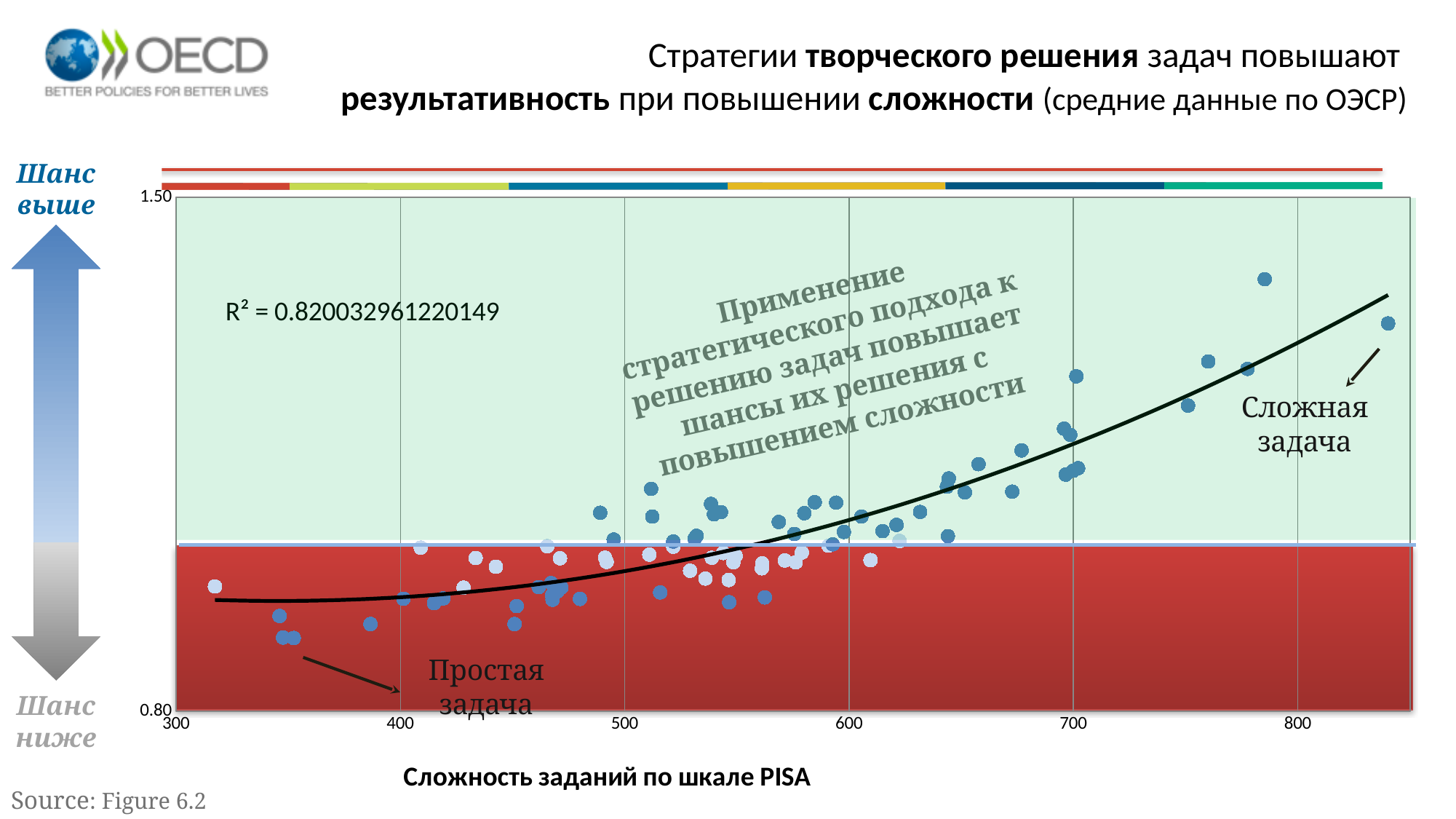
How many tick labels are shown along the x axis of the chart? 6 What kind of chart is shown on the slide? scatter chart What is the highest value shown on the x axis of the chart? 800 What is the label of the x axis of the chart? Сложность заданий по шкале PISA What R² value is printed on the chart? R² = 0.820032961220149 What is the bottom value labelled on the y axis of the chart? 0.80 Which annotation label points to the points at the low (left) end of the x axis: 'Простая задача' or 'Сложная задача'? Простая задача Do the plotted values generally rise or fall as the x-axis value (task difficulty on the PISA scale) increases? rise What is the lowest value shown on the x axis of the chart? 300 What is the top value labelled on the y axis of the chart? 1.50